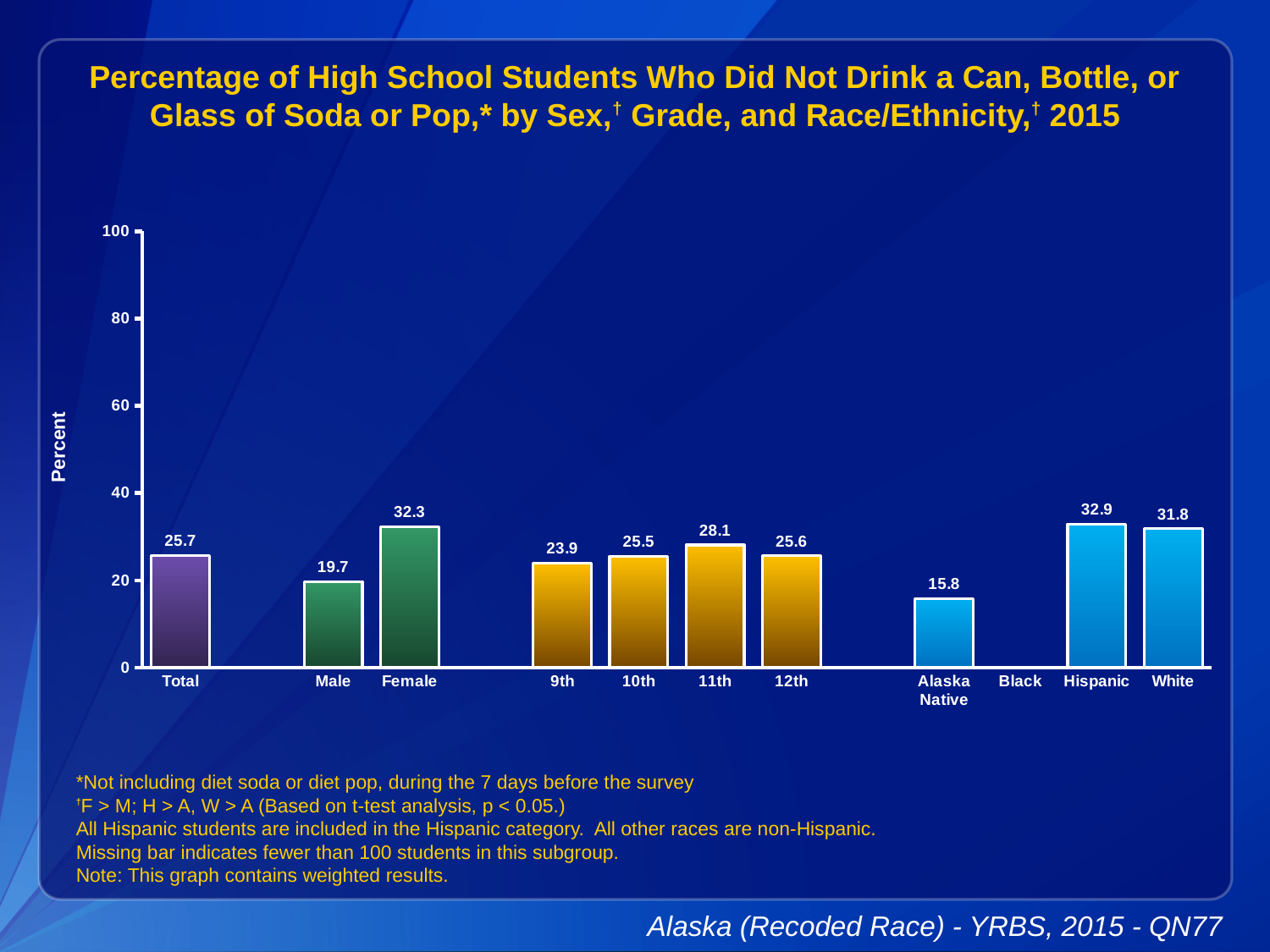
What is the value for 11th grade? 28.1 What is the value for Female? 32.3 Which category has the lowest value? Alaska Native What kind of chart is shown? bar chart What is the label on the y axis? Percent What is the value for Alaska Native? 15.8 Which category has the highest value? Hispanic Which is larger, the value for 9th grade or 12th grade? 12th Is the value for White greater or less than 20? greater How many bars are plotted on the chart? 10 Which category label has no bar plotted? Black What is the difference between the Female and Male values? 12.6